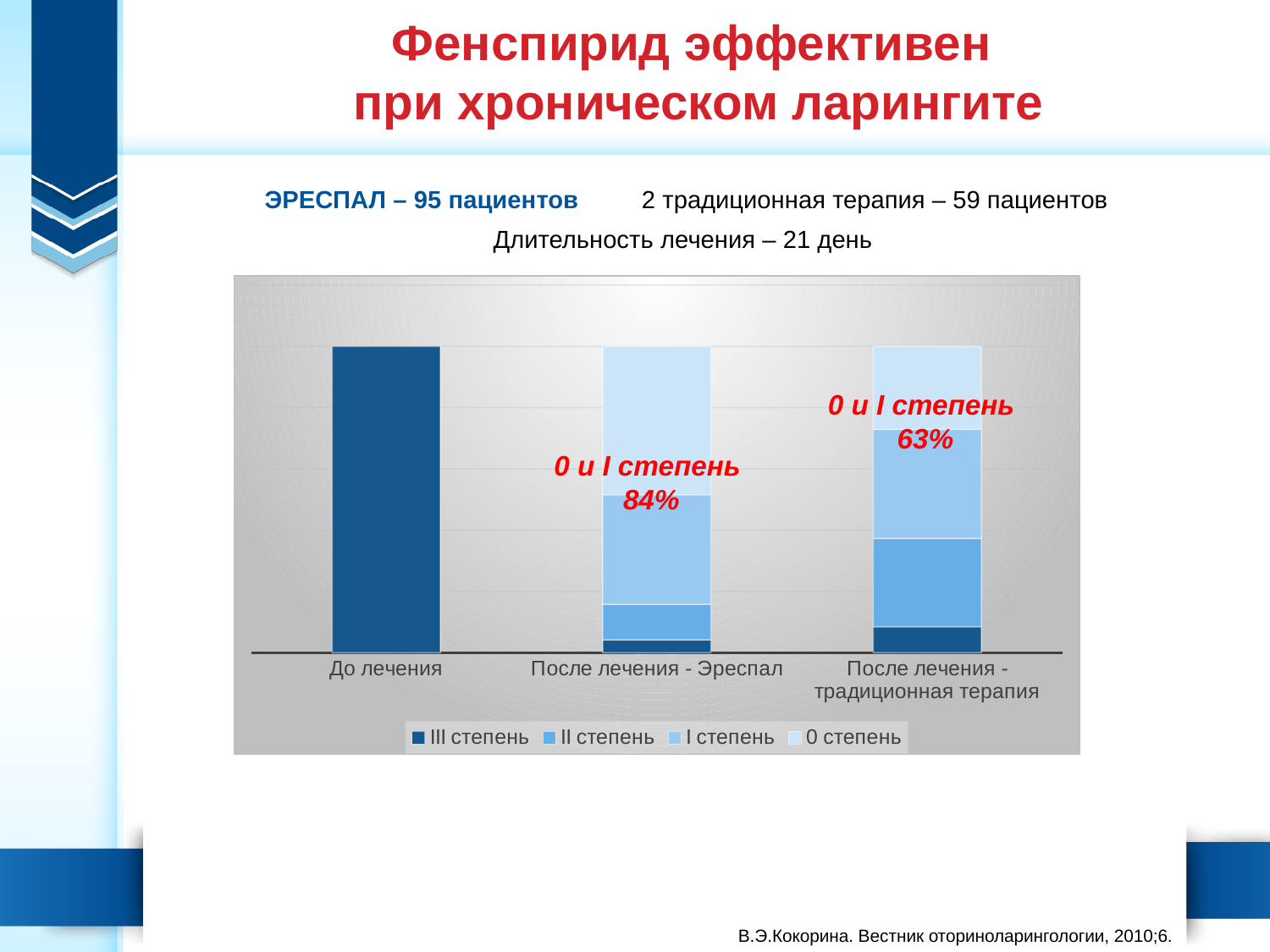
What combined share of patients had 0 и I степень after treatment with Эреспал? 84% Which group has the larger share of 0 и I степень after treatment: Эреспал or традиционная терапия? После лечения - Эреспал What are the four series listed in the chart legend? III степень, II степень, I степень, 0 степень What kind of chart is shown on the slide? Stacked bar chart Which category's bar consists of only one series? До лечения Which category has the smallest III степень segment? После лечения - Эреспал What combined share of patients had 0 и I степень after traditional therapy? 63% How many series does the chart legend list? 4 How many categories are shown on the x axis of the chart? 3 Is the 0 степень segment larger for После лечения - Эреспал or for После лечения - традиционная терапия? После лечения - Эреспал Which category has the largest III степень segment? До лечения What is the difference between the 0 и I степень share after Эреспал (84%) and after traditional therapy (63%)? 21%